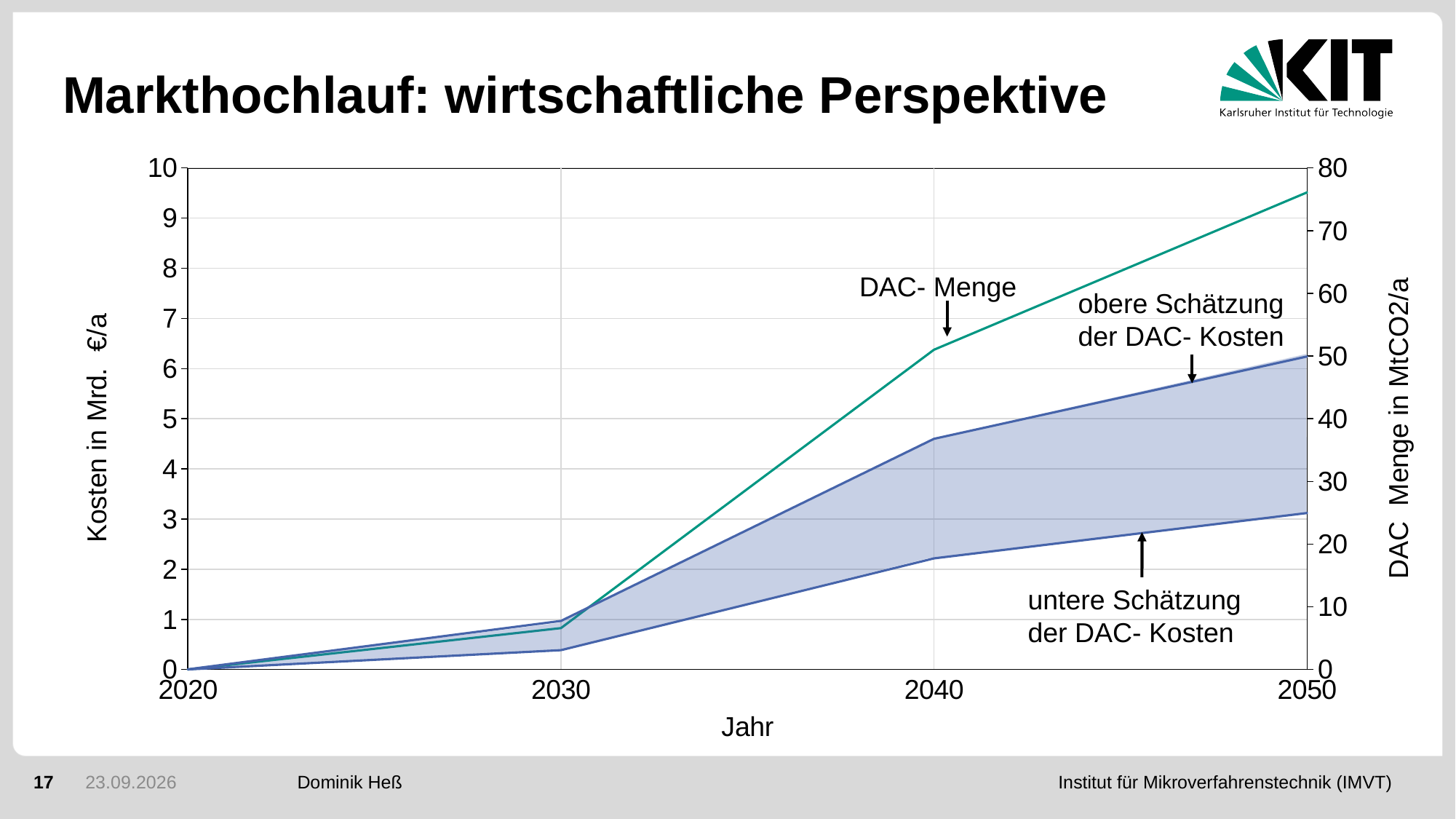
How many years are marked on the x axis of the chart? 4 Is the value of DAC- Menge in 2040 greater or less than 40 MtCO2/a? greater Is the value of DAC- Menge in 2050 greater or less than 70 MtCO2/a? greater Which is larger in 2050, the obere Schätzung or the untere Schätzung der DAC- Kosten? obere Schätzung Is the untere Schätzung der DAC- Kosten in 2050 greater or less than 4 Mrd. €/a? less What is the label of the left y axis of the chart? Kosten in Mrd. €/a What is the label of the x axis of the chart? Jahr What kind of chart is shown on the slide? line chart Does the DAC- Menge rise or fall from 2020 to 2050? rise